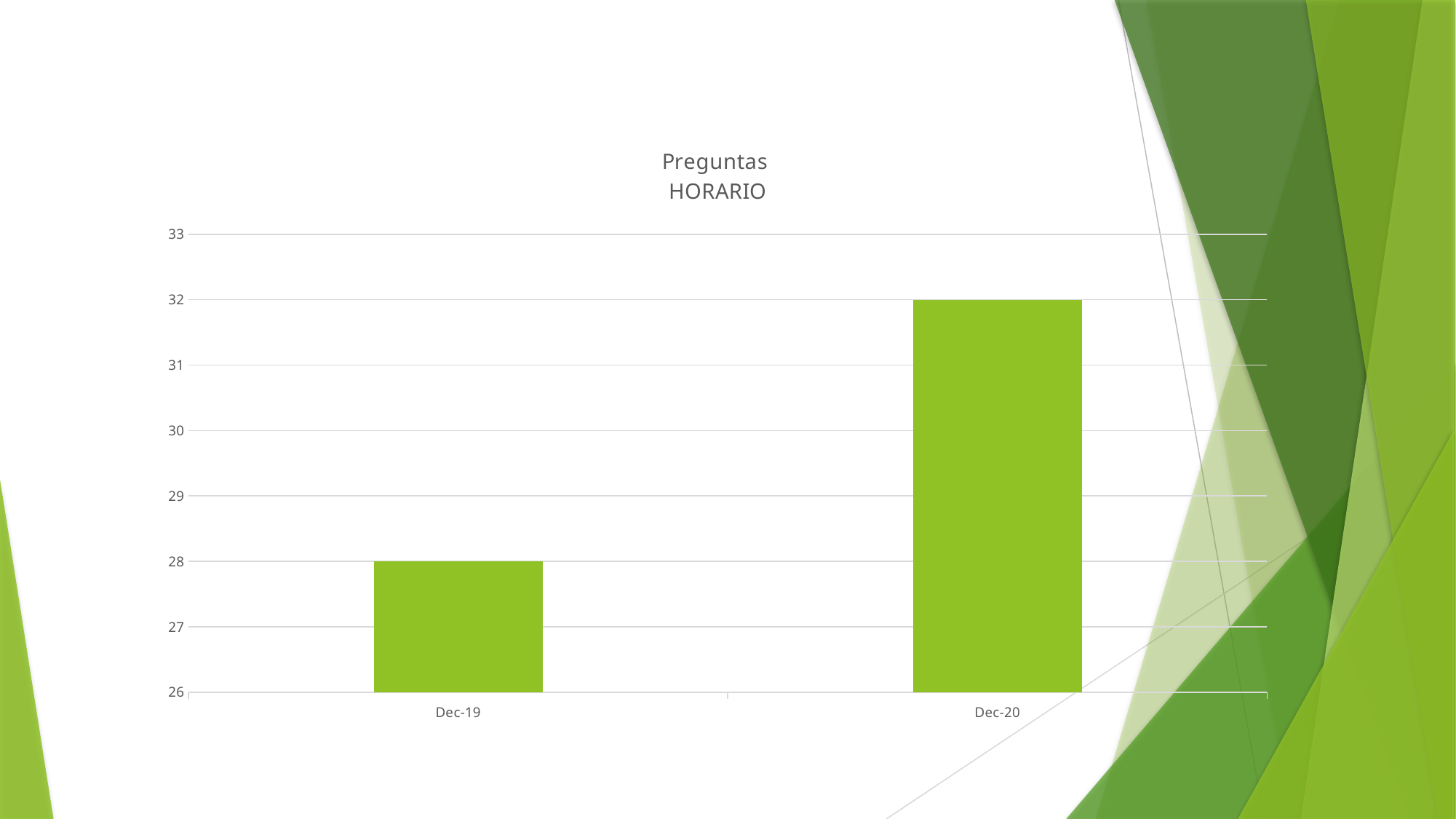
What is the lowest value shown on the vertical axis? 26 What type of chart is shown on the slide? bar chart Which category has the highest value? Dec-20 What is the value for Dec-20? 32 Which category has the lowest value? Dec-19 Which is larger, the value for Dec-19 or the value for Dec-20? Dec-20 Is the value for Dec-20 greater or less than 30? greater Do the values rise or fall from Dec-19 to Dec-20? rise What is the difference between the values for Dec-20 and Dec-19? 4 How many categories are shown on the x axis? 2 What is the title of the chart? Preguntas HORARIO What is the value for Dec-19? 28